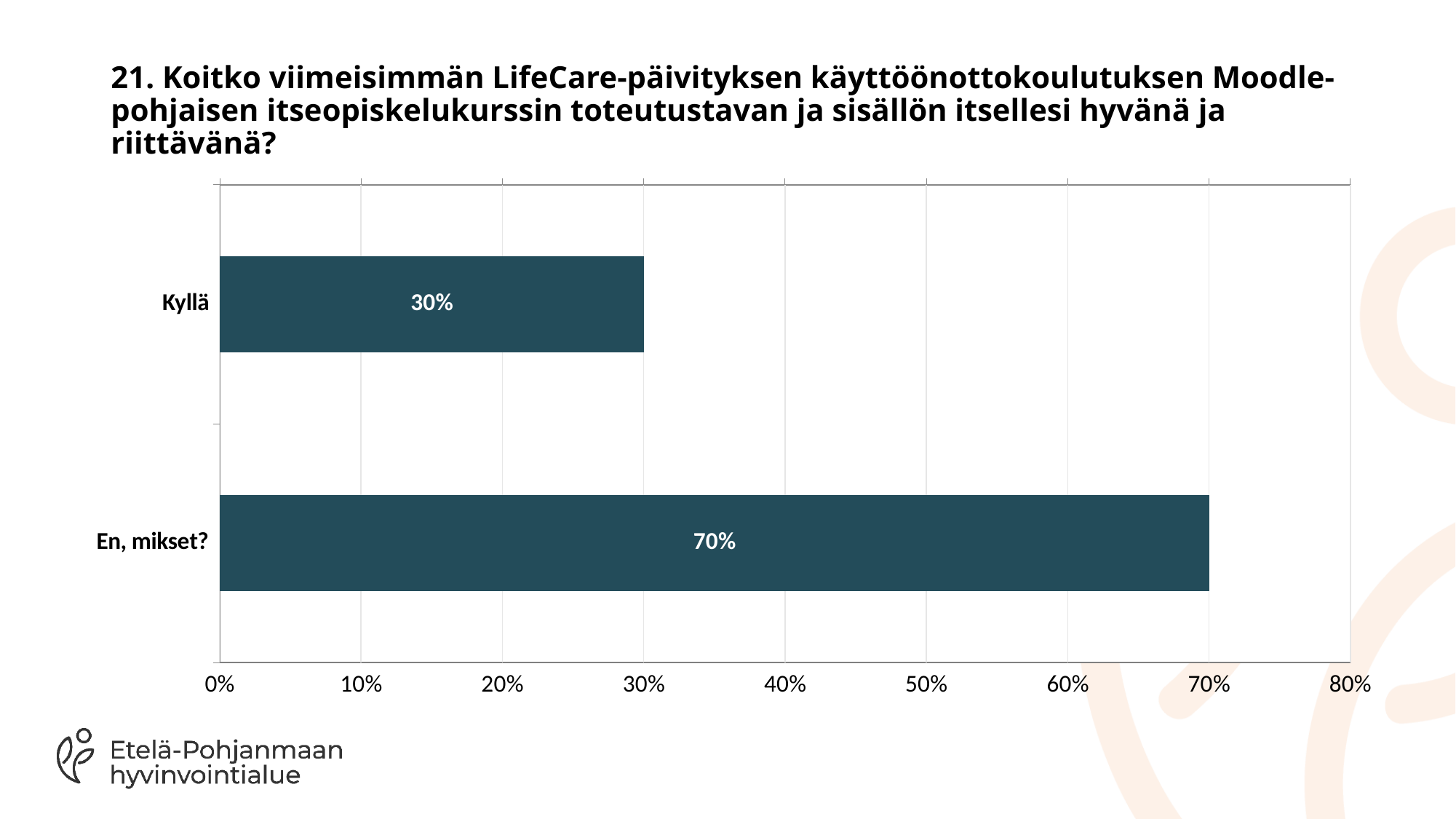
Is the value for En, mikset? greater or less than 50%? greater Is the value for Kyllä greater or less than 40%? less What is the value for En, mikset? 70% What kind of chart is shown on the slide? bar chart Which category has the highest value? En, mikset? Which is larger, the value for Kyllä or the value for En, mikset? En, mikset? What is the total of the two values shown in the chart? 100% What is the highest value shown on the x axis? 80% Which category has the lowest value? Kyllä What is the difference between the values for En, mikset? and Kyllä? 40% How many categories are shown in the chart? 2 What is the value for Kyllä? 30%